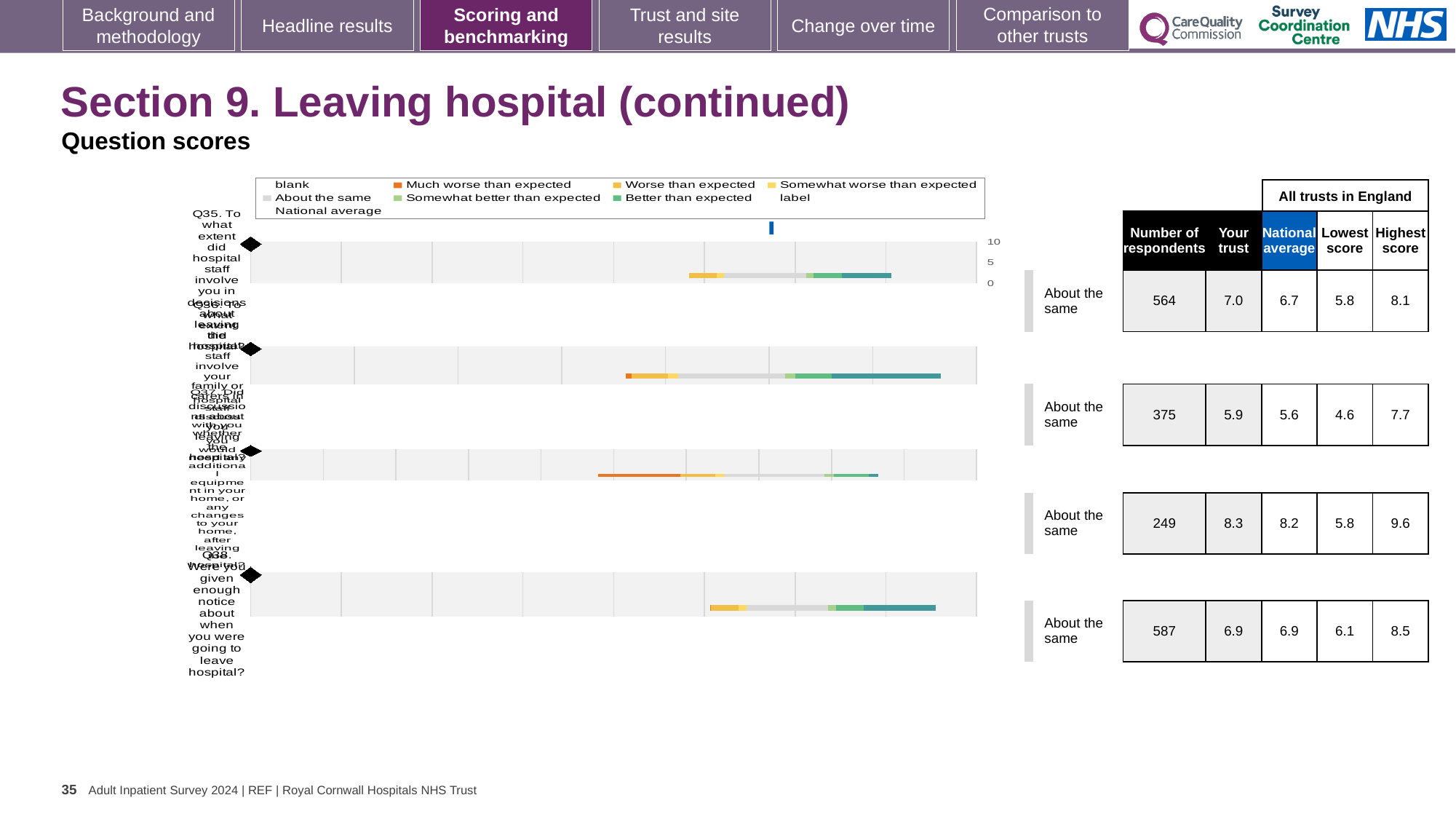
In the table beside the charts, which row has the highest 'Your trust' score? the third row (8.3) What is the highest value shown on the axis of the first chart (Q35)? 10 In the legend, what colour represents 'Better than expected'? teal What kind of chart is used to show the question scores on this slide? bar chart What benchmark label is shown next to each of the four charts? About the same In the table beside the charts, which row has the lowest 'Your trust' score? the second row (5.9) In the table beside the charts, what is the 'Your trust' score for the first row (Q35)? 7.0 In the table beside the charts, what is the number of respondents for the last row (Q38)? 587 In the table beside the charts, what is the difference between the 'Your trust' score and the national average in the first row (Q35)? 0.3 In the legend, what colour represents 'Much worse than expected'? orange How many entries does the legend above the charts list? 9 How many separate question-score charts are shown on the slide? 4